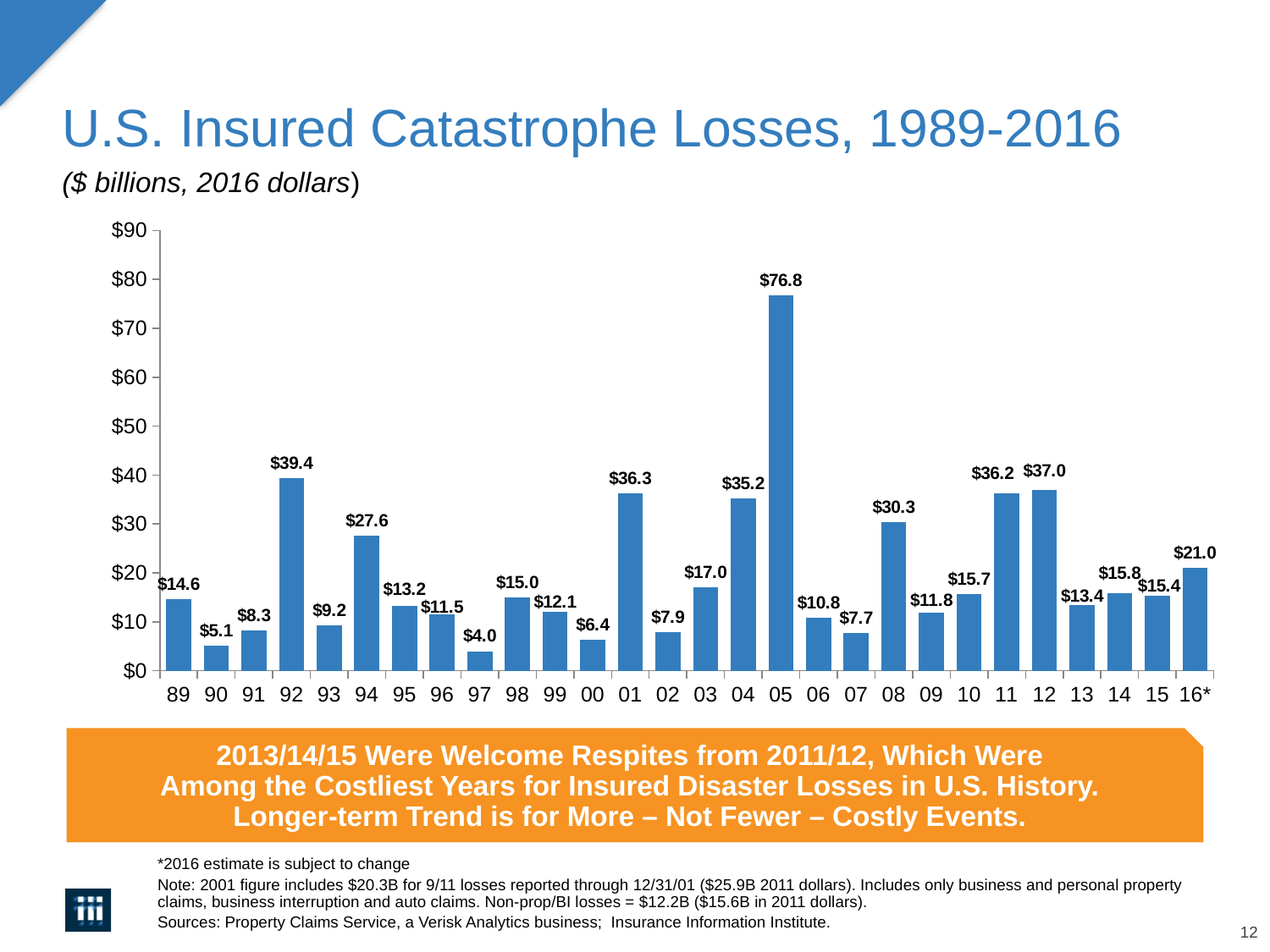
What is the value for 1992 (92)? $39.4 Which is larger, the value for 2001 (01) or the value for 2004 (04)? 01 What is the value for 2016 (16*)? $21.0 Is the value for 2008 (08) greater or less than $20? greater How many years are shown on the x axis? 28 Which year has the highest insured catastrophe losses? 05 What kind of chart is this? Bar chart What is the difference between the values for 2012 (12) and 2011 (11)? $0.8 What is the value for 2005 (05)? $76.8 What is the title of the chart? U.S. Insured Catastrophe Losses, 1989-2016 Do the values rise or fall from 2013 (13) to 2014 (14)? Rise Which year has the lowest insured catastrophe losses? 97